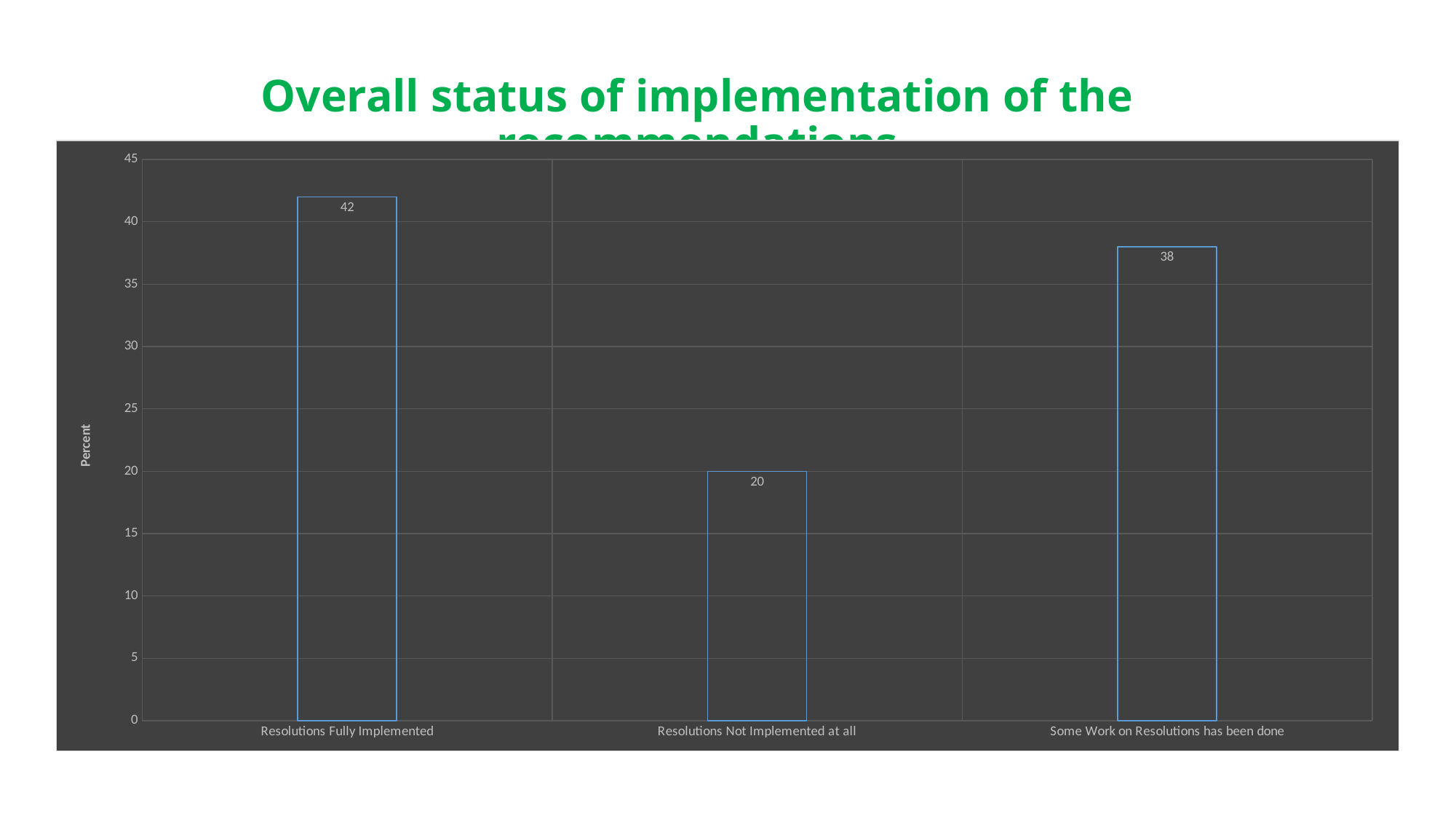
What is the value for Resolutions Not Implemented at all? 20 How many categories are shown on the chart? 3 Which is larger, the value for Resolutions Not Implemented at all or the value for Some Work on Resolutions has been done? Some Work on Resolutions has been done What is the label on the vertical axis of the chart? Percent What kind of chart is shown on the slide? bar chart What is the value for Resolutions Fully Implemented? 42 Which category has the highest value? Resolutions Fully Implemented What is the value for Some Work on Resolutions has been done? 38 What is the difference between the values for Some Work on Resolutions has been done and Resolutions Not Implemented at all? 18 What is the difference between the values for Resolutions Fully Implemented and Some Work on Resolutions has been done? 4 Which category has the lowest value? Resolutions Not Implemented at all Is the value for Some Work on Resolutions has been done greater or less than 40? less